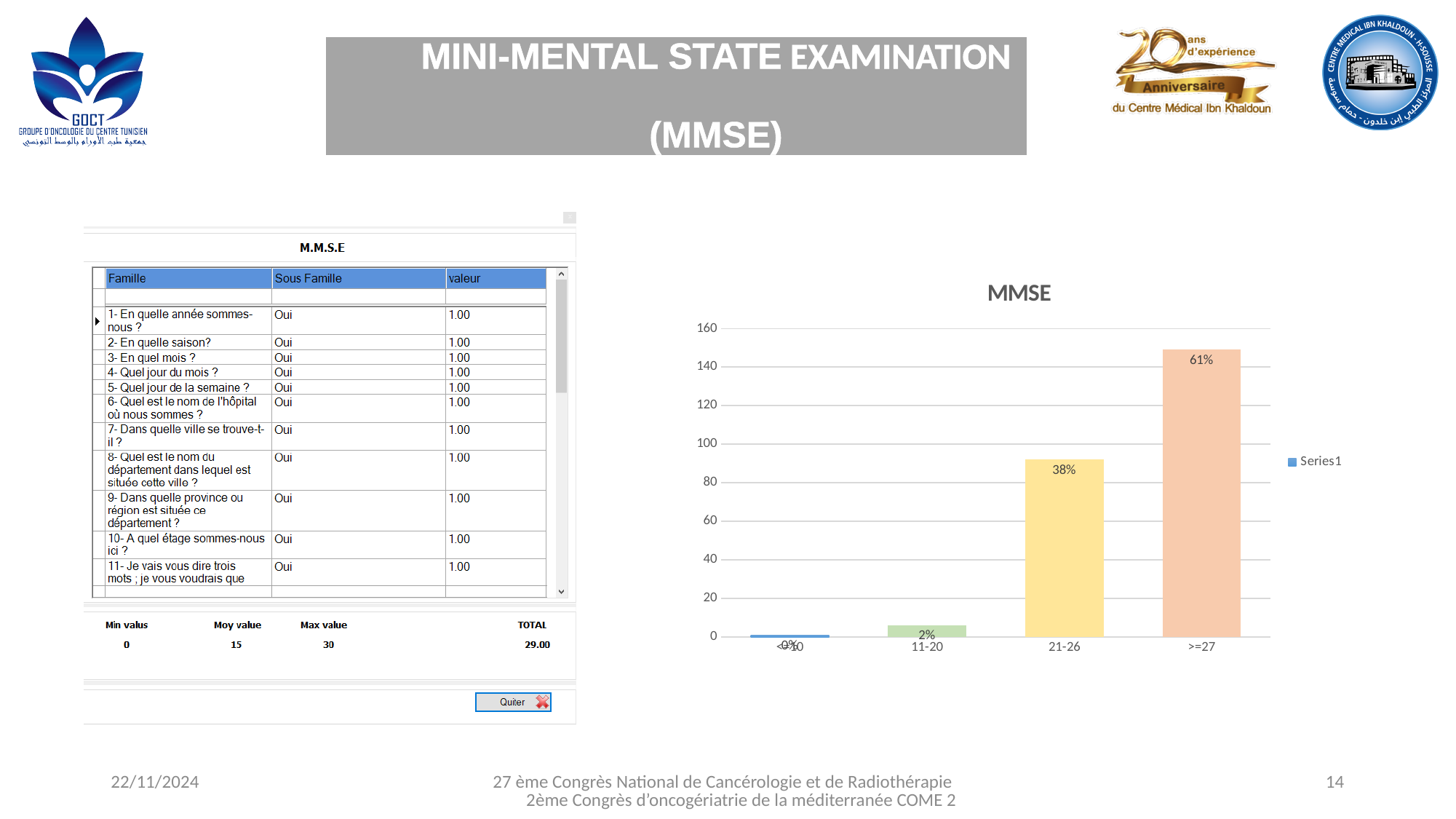
What is the chart's title? MMSE What is the data label shown on the bar for the >=27 category? 61% How many series does the legend list? 1 What is the data label shown on the bar for the 11-20 category? 2% Do the bar heights rise or fall from left to right along the x axis? rise Which is larger, the bar for 21-26 or the bar for 11-20? 21-26 How many categories are shown on the x axis of the MMSE chart? 4 What type of chart is shown on the slide? bar chart Which category has the highest bar? >=27 Which category has the lowest bar? <=10 What is the data label shown on the bar for the 21-26 category? 38% Is the value for the >=27 bar greater or less than 140 on the y axis? greater